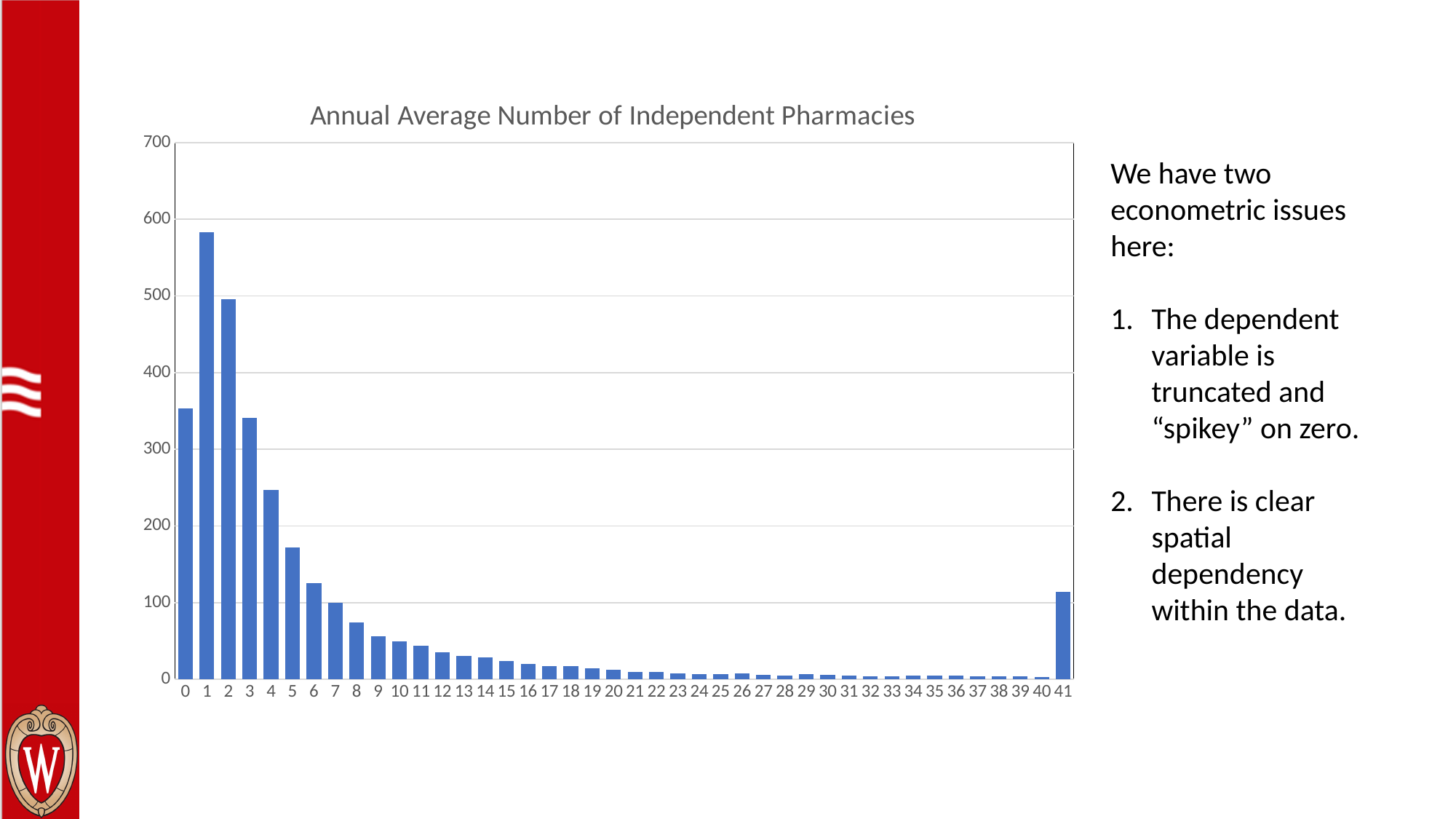
Is the value for category 1 greater or less than 500? greater Is the value for category 8 greater or less than 100? less Which has a larger value, category 40 or category 41? 41 Is the value for category 5 greater or less than 200? less How many categories are shown on the x axis of the chart? 42 What kind of chart is shown on the slide? bar chart Which has a larger value, category 0 or category 2? 2 Do the values rise or fall from category 1 through category 40? fall What is the title of the chart? Annual Average Number of Independent Pharmacies Which category has the highest value in the chart? 1